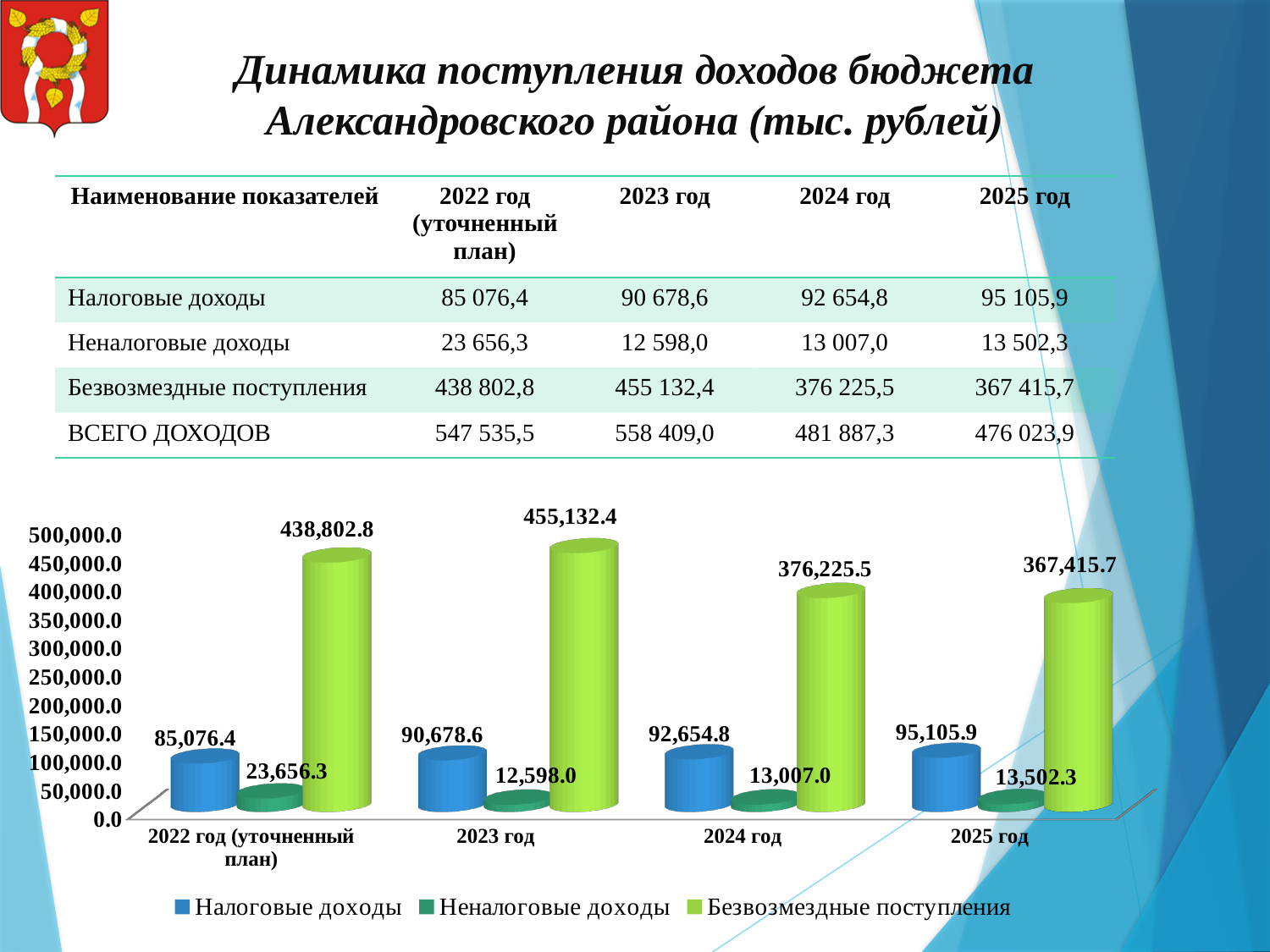
What is the value for Налоговые доходы in 2023 год? 90,678.6 What is the value for Безвозмездные поступления in 2024 год? 376,225.5 In which year is Неналоговые доходы lowest? 2023 год What kind of chart is shown on the slide? bar chart Do the values for Налоговые доходы rise or fall from 2022 to 2025? rise What is the difference between Безвозмездные поступления in 2023 год and 2024 год? 78,906.9 What is the value for Неналоговые доходы in 2025 год? 13,502.3 In which year is Безвозмездные поступления highest? 2023 год Is the value for Безвозмездные поступления in 2025 год greater or less than 400,000.0? less How many series does the legend list? 3 How many year categories are shown on the x axis? 4 Which is larger: Налоговые доходы in 2024 год or Налоговые доходы in 2025 год? 2025 год